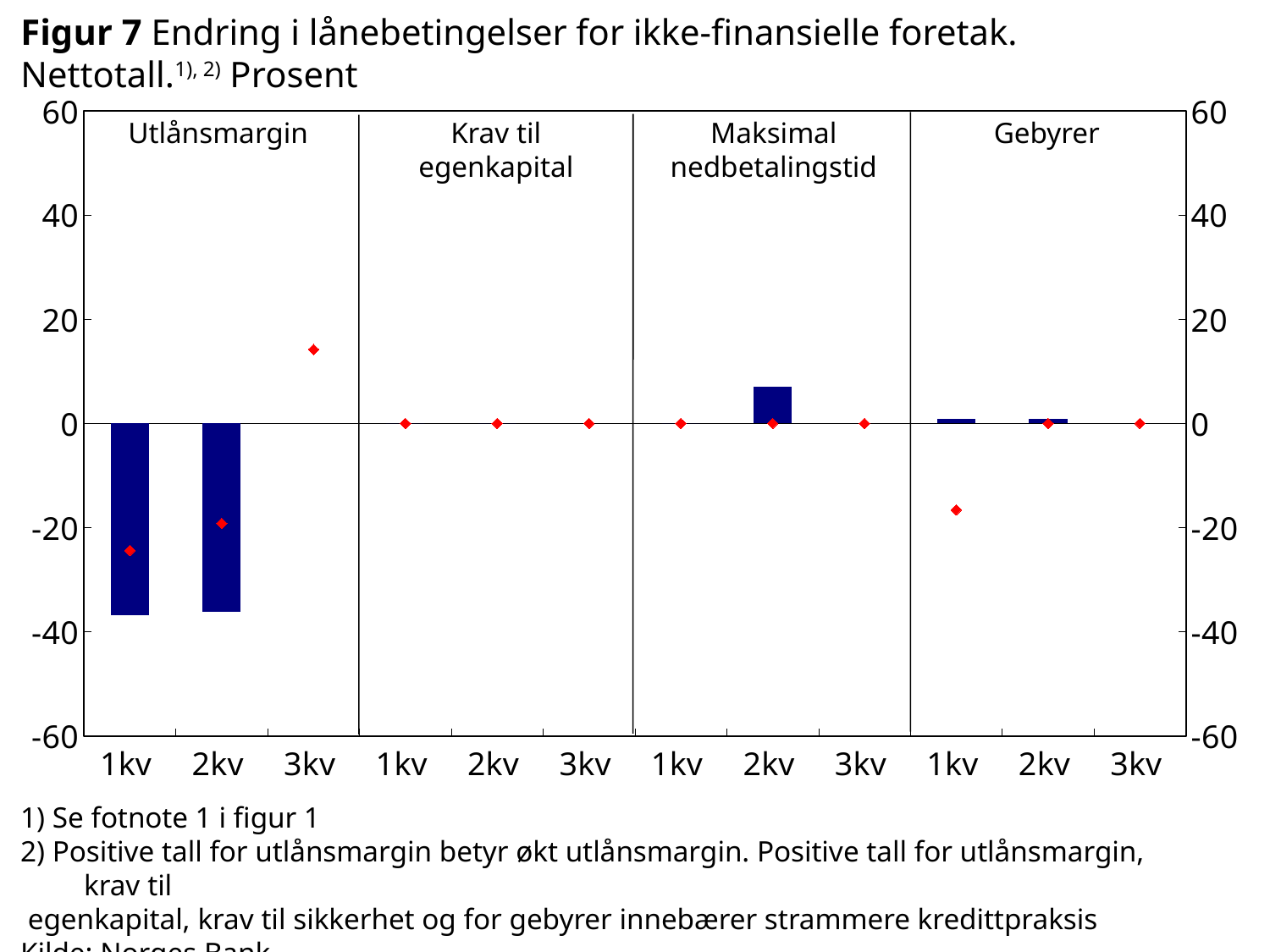
Is the red diamond for 3kv in the Utlånsmargin panel greater or less than 0? greater Is the bar for 2kv in the Utlånsmargin panel greater or less than -40? greater Which panel has the largest negative bars? Utlånsmargin Is the red diamond for 3kv in the Utlånsmargin panel greater or less than 20? less How many quarters are shown on the x axis within each panel? 3 Do the red diamonds in the Utlånsmargin panel rise or fall from 1kv to 3kv? rise How many panels (loan condition categories) does the chart have? 4 What kind of chart is shown in Figur 7? combination bar and line chart (bars with red diamond markers) What is the unit stated in the chart title? Prosent